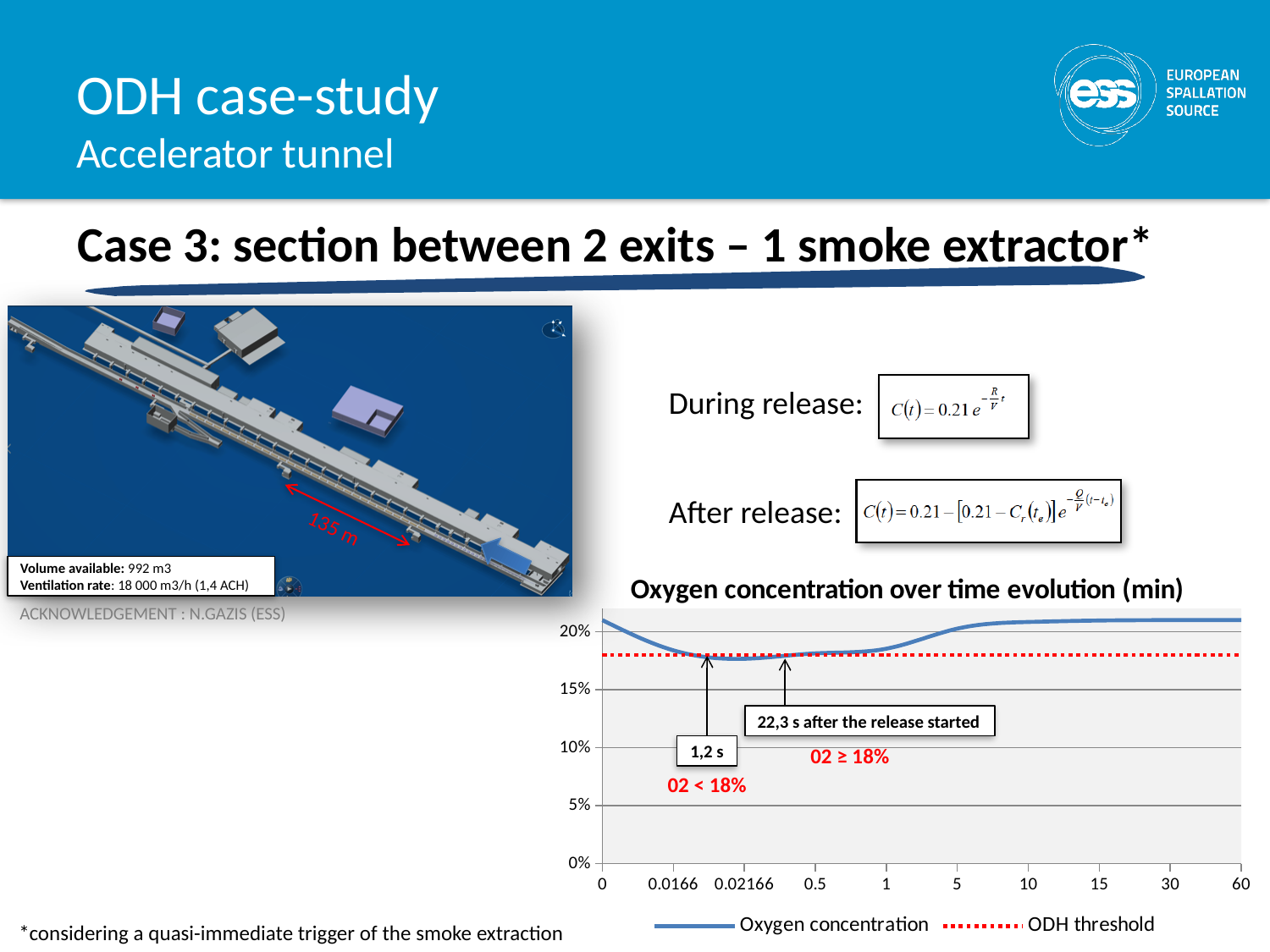
Does the oxygen concentration rise or fall between time 1 and time 5? rise According to the annotation on the chart, when does the oxygen concentration return to 18% or above? 22,3 s after the release started At time 0, is the oxygen concentration higher or lower than the ODH threshold line? higher Is the oxygen concentration at time 0 greater or less than 20%? greater What are the two legend entries of the oxygen concentration chart? Oxygen concentration and ODH threshold According to the annotation on the chart, how long after the release starts does the oxygen concentration drop below 18%? 1,2 s Is the oxygen concentration at time 0.02166 greater or less than 20%? less How many series does the legend of the oxygen concentration chart list? 2 What kind of chart is shown under the title 'Oxygen concentration over time evolution (min)'? line chart How many tick labels are shown on the x axis of the oxygen concentration chart? 10 Does the oxygen concentration rise or fall between time 0 and time 0.02166? fall What is the title of the chart on the slide? Oxygen concentration over time evolution (min)